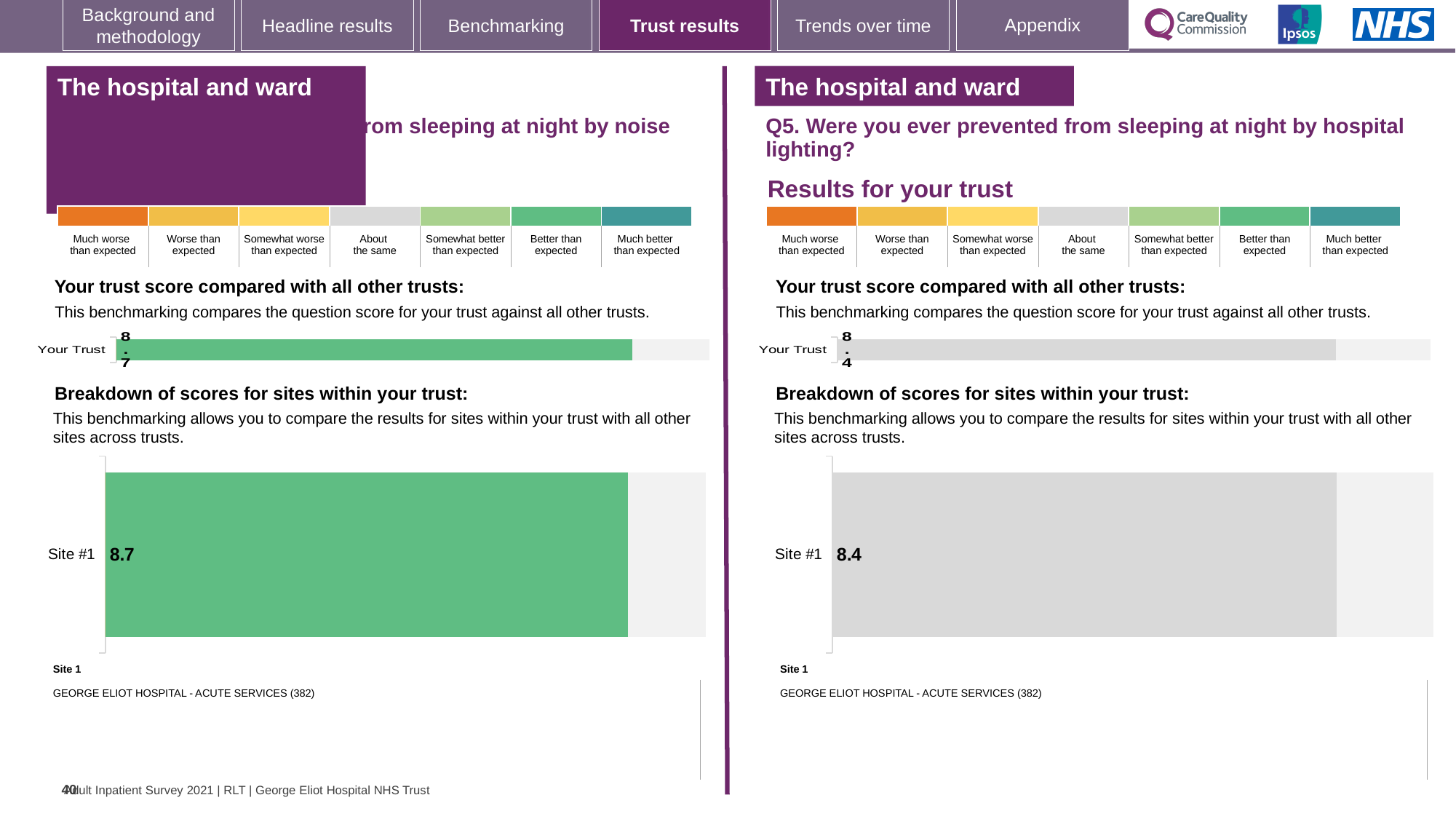
What kind of chart is used to show the Site #1 score on the left-hand side of the slide? Bar chart Is the Site #1 score on the right-hand chart for Q5 (hospital lighting) greater or less than the Site #1 score on the left-hand chart? less In the right-hand breakdown chart for Q5 (hospital lighting), what is the score for Site #1? 8.4 In the left-hand breakdown chart (sleeping at night by noise), what is the score for Site #1? 8.7 According to the colour key, which benchmark category does the green colour of the left-hand Your Trust bar correspond to? Better than expected What colour is the Site #1 bar in the right-hand breakdown chart for Q5 (hospital lighting)? Grey Which Your Trust score is higher: the left-hand chart (noise) or the right-hand chart (Q5 hospital lighting)? The left-hand chart (noise), 8.7 What is the difference between the Site #1 score on the left-hand chart (8.7) and the Site #1 score on the right-hand chart for Q5 (8.4)? 0.3 How many sites are shown in the right-hand breakdown chart for Q5 (hospital lighting)? 1 On the right-hand chart for Q5 (hospital lighting), what is the score shown for Your Trust? 8.4 On the left-hand chart (sleeping at night by noise), what is the score shown for Your Trust? 8.7